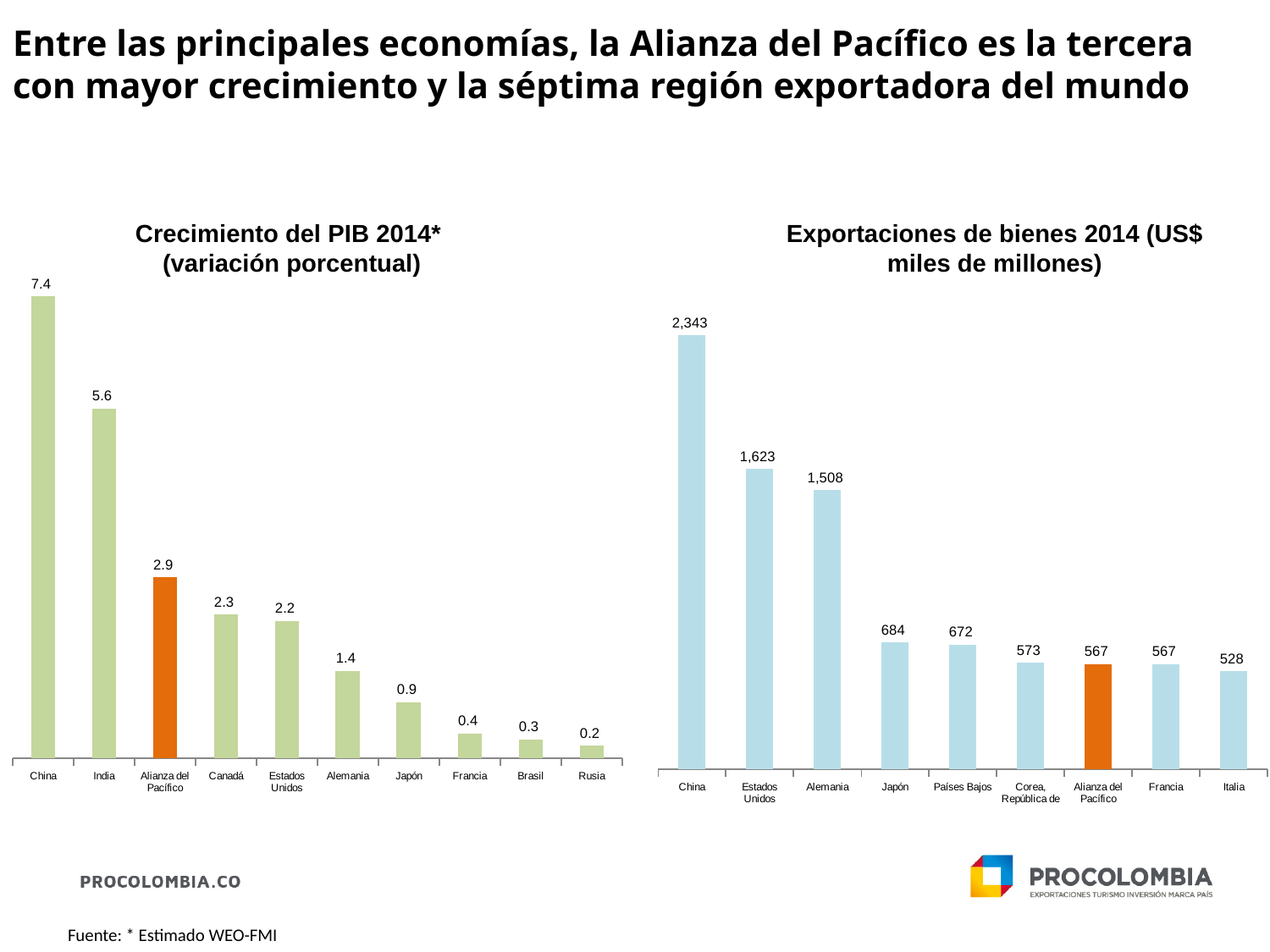
In the 'Crecimiento del PIB 2014*' chart, what is the value for Alianza del Pacífico? 2.9 In the 'Crecimiento del PIB 2014*' chart, how many categories are shown? 10 In the 'Exportaciones de bienes 2014' chart, which category has the lowest value? Italia In the 'Exportaciones de bienes 2014' chart, what is the value for Estados Unidos? 1,623 In the 'Crecimiento del PIB 2014*' chart, which category has the lowest value? Rusia In the 'Crecimiento del PIB 2014*' chart, which category has the highest value? China In the 'Exportaciones de bienes 2014' chart, what is the difference between the values for China and Alemania? 835 In the 'Exportaciones de bienes 2014' chart, what is the value for Alianza del Pacífico? 567 In the 'Exportaciones de bienes 2014' chart, which is larger, the value for Japón or the value for Países Bajos? Japón What type of chart is the 'Crecimiento del PIB 2014*' chart? Bar chart In the 'Exportaciones de bienes 2014' chart, how many categories are shown? 9 In the 'Crecimiento del PIB 2014*' chart, what is the difference between the values for China and India? 1.8